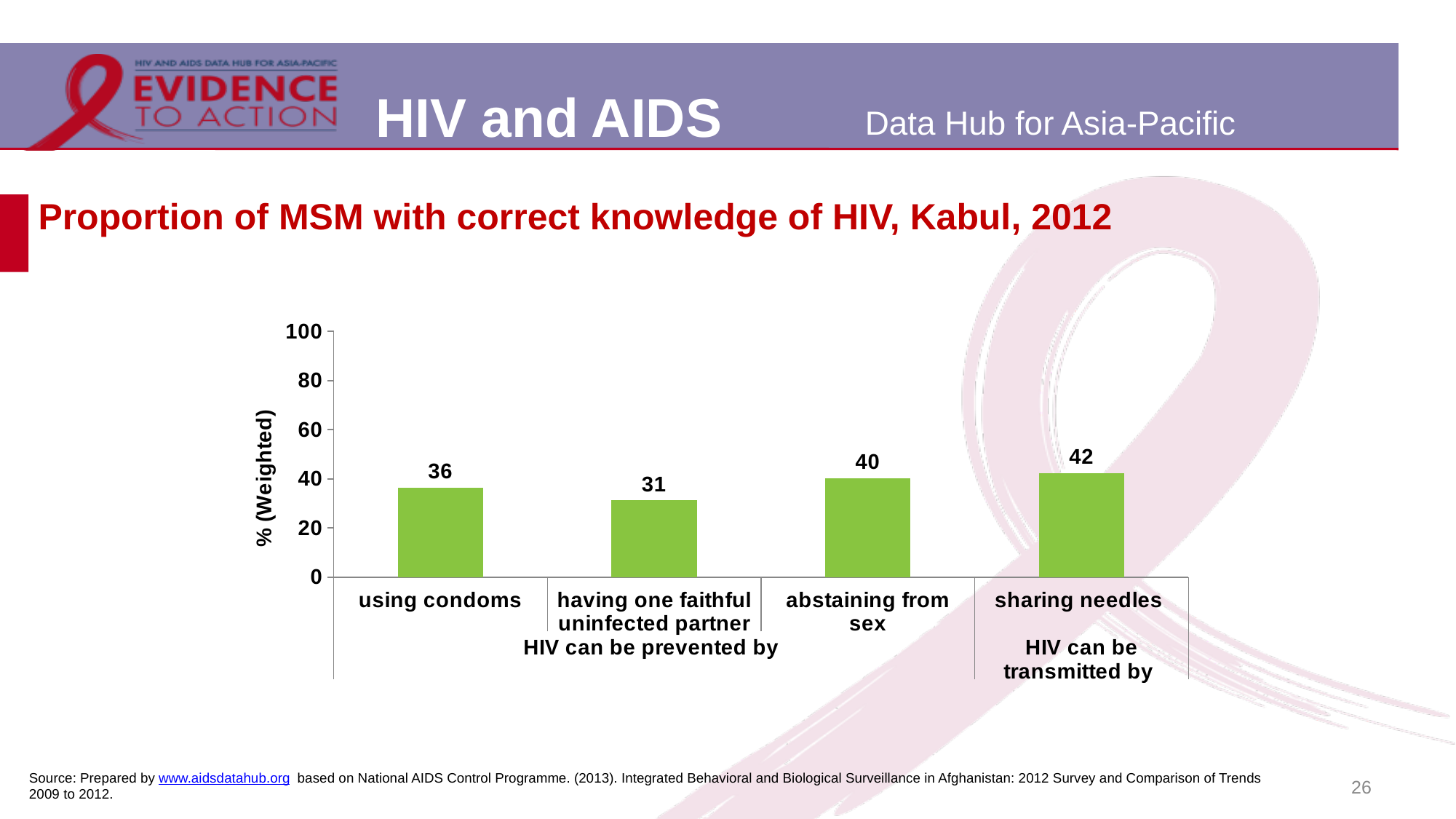
What is the label of the vertical axis? % (Weighted) What is the value for 'abstaining from sex'? 40 Which category has the lowest value? having one faithful uninfected partner Which category has the highest value? sharing needles How many categories are shown in the chart? 4 What kind of chart is shown on the slide? bar chart What is the value for 'sharing needles'? 42 Which is larger, the value for 'using condoms' or the value for 'abstaining from sex'? abstaining from sex What is the value for 'using condoms'? 36 What is the value for 'having one faithful uninfected partner'? 31 Is the value for 'using condoms' greater or less than 60? less What is the difference between the values for 'sharing needles' and 'having one faithful uninfected partner'? 11